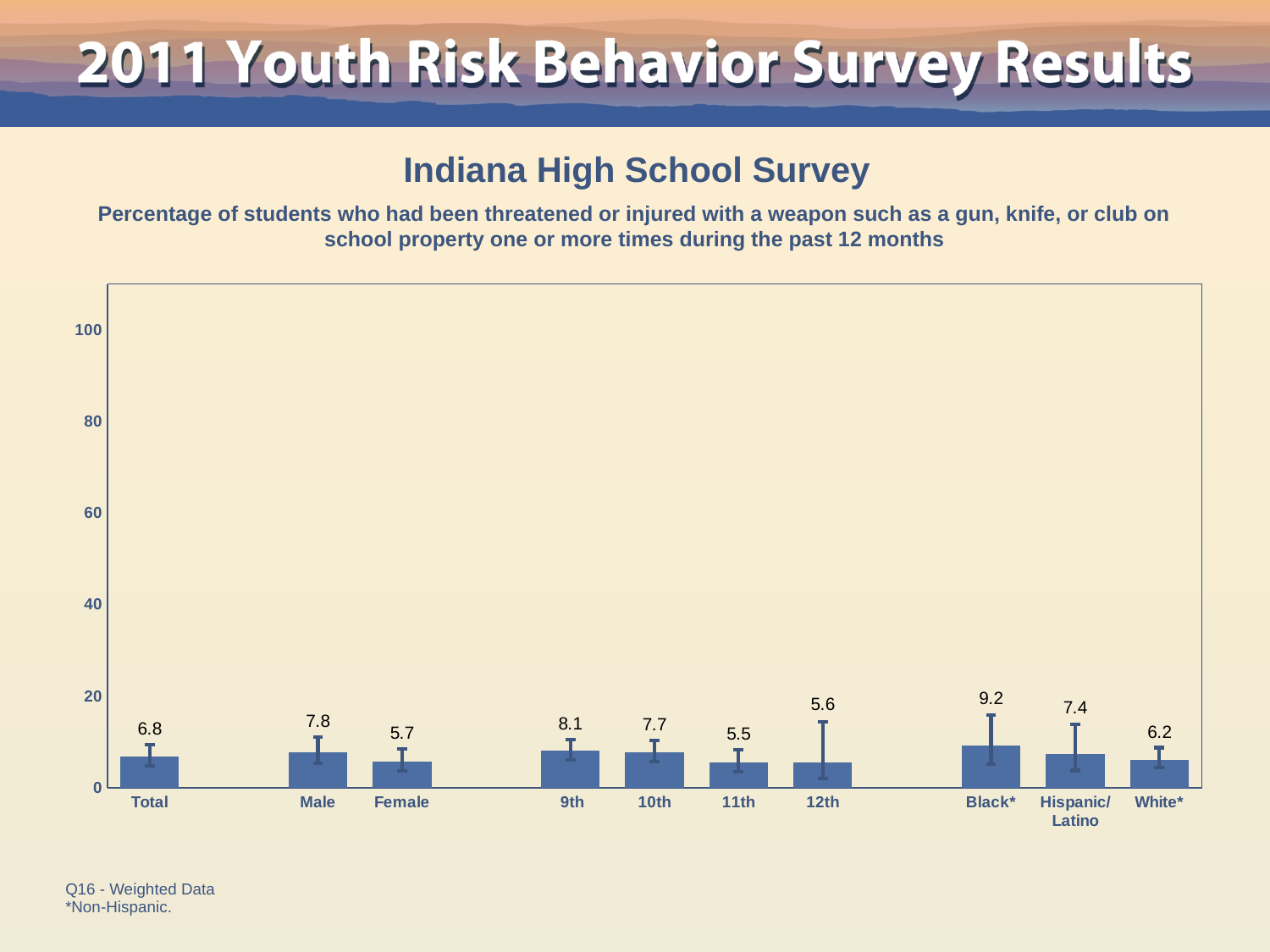
Which category has the lowest value? 11th What is the difference between the values for Black* and White*? 3.0 What is the value for Male? 7.8 What is the value for Total? 6.8 Is the value for Black* greater or less than 20? less What is the value for Hispanic/Latino? 7.4 Which is larger, the value for 9th or the value for 10th? 9th How many categories are shown on the x axis? 10 Which category has the highest value? Black* What is the difference between the values for Male and Female? 2.1 What kind of chart is this? bar chart What is the value for 12th? 5.6